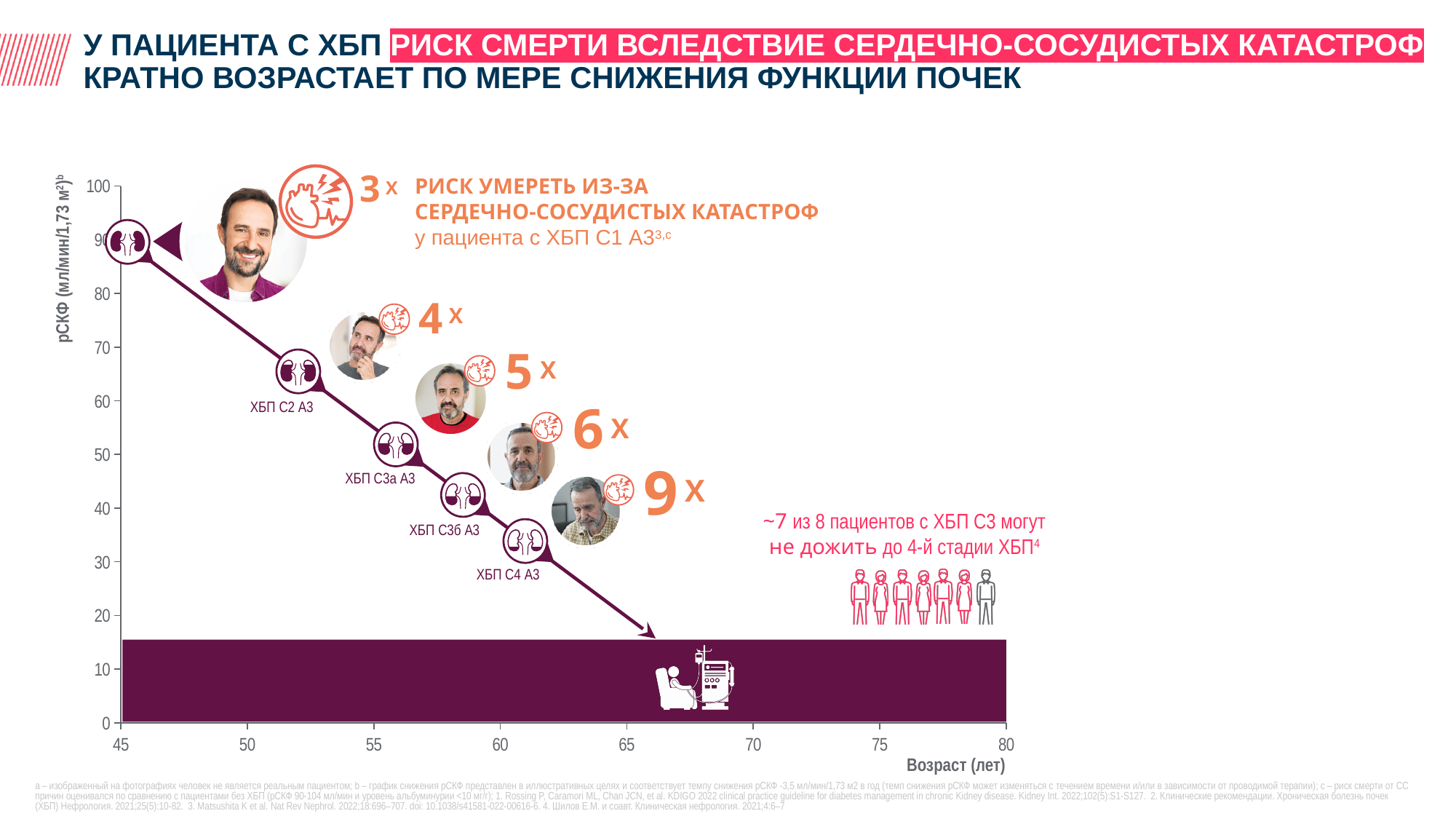
What risk multiplier is shown next to the ХБП С4 А3 point? 9 x Do the рСКФ values rise or fall as age increases along the x axis? fall Is the рСКФ value at the ХБП С2 А3 point greater or less than 60? greater What is the label of the y axis? рСКФ (мл/мин/1,73 м²) What risk multiplier is shown for a patient with ХБП С1 А3? 3 x Which point has a higher рСКФ value: ХБП С2 А3 or ХБП С3б А3? ХБП С2 А3 What risk multiplier is shown next to the ХБП С3а А3 point? 5 x Is the рСКФ value at the ХБП С4 А3 point greater or less than 40? less What kind of chart is shown on the slide? line chart What is the label of the x axis? Возраст (лет) Is the рСКФ value at the ХБП С3а А3 point greater or less than 60? less How many kidney markers are plotted along the line? 5